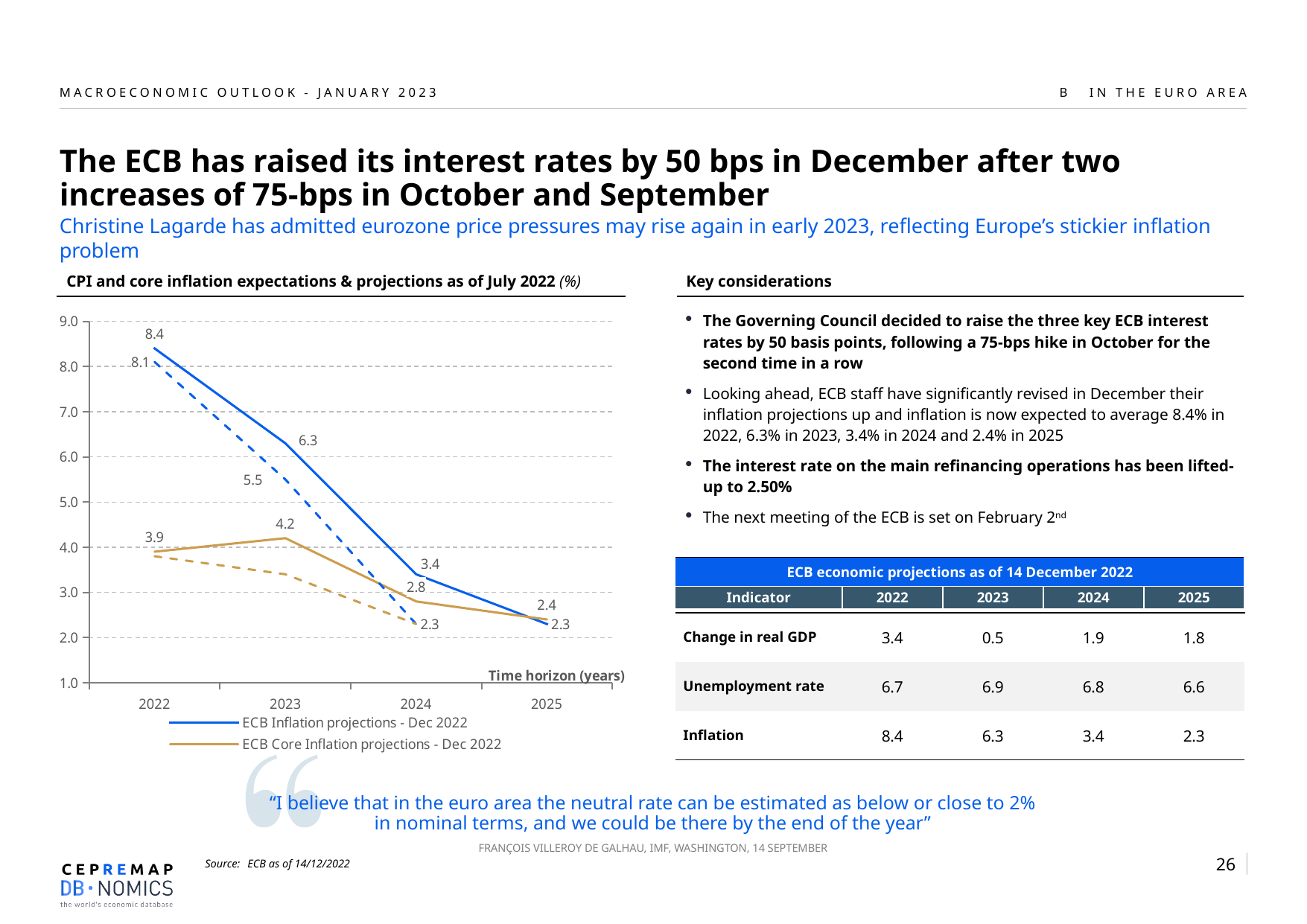
What is the difference between the ECB Inflation projections - Dec 2022 values for 2022 and 2023? 2.1 What is the value of the ECB Core Inflation projections - Dec 2022 series for 2024? 2.8 Do the ECB Inflation projections - Dec 2022 rise or fall from 2022 to 2025? Fall What is the value of the ECB Inflation projections - Dec 2022 series for 2023? 6.3 In which year is the ECB Inflation projections - Dec 2022 series at its highest? 2022 What is the value of the ECB Inflation projections - Dec 2022 series for 2025? 2.3 For 2024, which is larger: the ECB Inflation projection or the ECB Core Inflation projection? ECB Inflation projection (3.4) What kind of chart is shown on the slide? Line chart How many years are shown on the x axis of the chart? 4 What is the value of the ECB Core Inflation projections - Dec 2022 series for 2023? 4.2 How many series does the chart legend list? 2 What is the value of the ECB Inflation projections - Dec 2022 series for 2022? 8.4